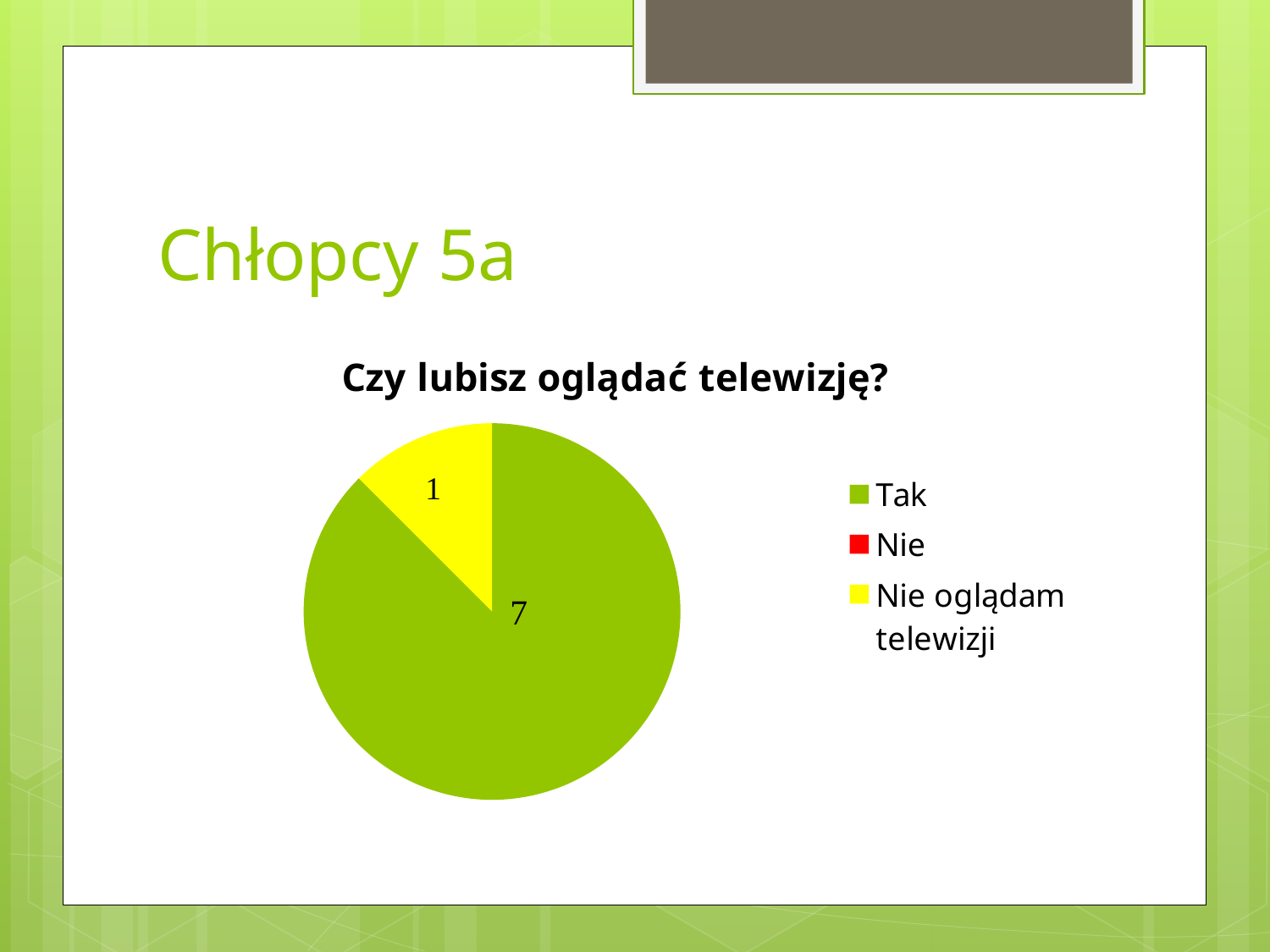
What colour is the "Tak" slice? green What type of chart is shown on the slide? pie chart How many categories does the legend list? 3 Which category has the largest slice of the pie? Tak What is the value for the "Nie oglądam telewizji" slice? 1 What is the difference between the "Tak" value and the "Nie oglądam telewizji" value? 6 Which of the visible slices is the smallest? Nie oglądam telewizji How many slices are visible in the pie? 2 What is the title of the chart? Czy lubisz oglądać telewizję? What is the value for the "Tak" slice? 7 Which is larger, the value for "Tak" or the value for "Nie oglądam telewizji"? Tak